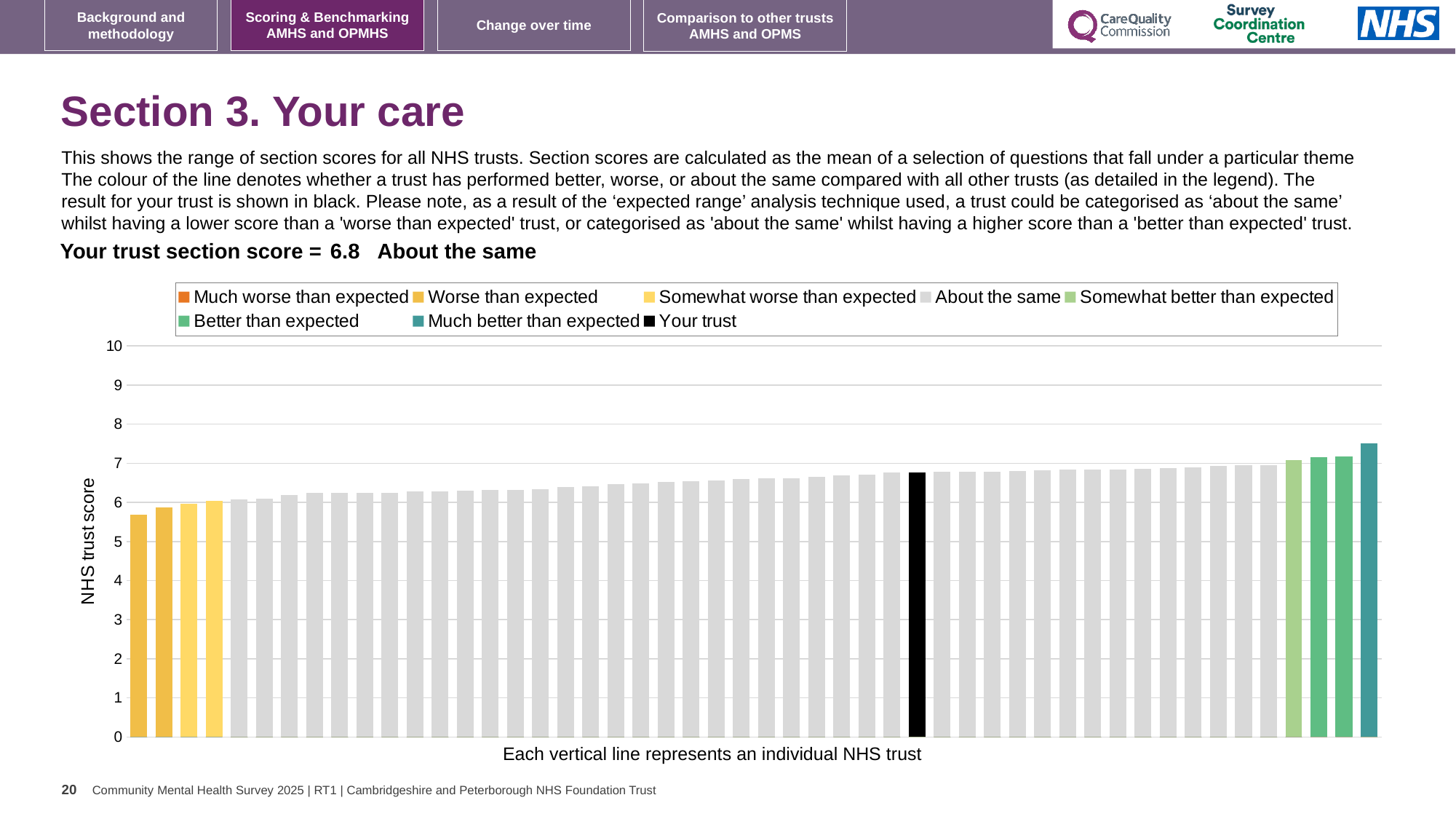
Is the value of the shortest bar on the chart greater or less than 6? less Is the bar for your trust taller or shorter than the 'Much better than expected' bar? shorter What is the section score for your trust shown on the slide? 6.8 Is the value for your trust (the black bar) greater or less than 7? less What kind of chart is shown on the slide? bar chart Which legend category does the tallest bar belong to? Much better than expected Do the bar values rise or fall from left to right along the x axis? rise Is the value of the tallest bar (Much better than expected) greater or less than 7? greater What is the title of the vertical axis? NHS trust score How many entries does the chart legend list? 8 Which legend category does the shortest bar belong to? Worse than expected Which category is your trust placed in for this section? About the same